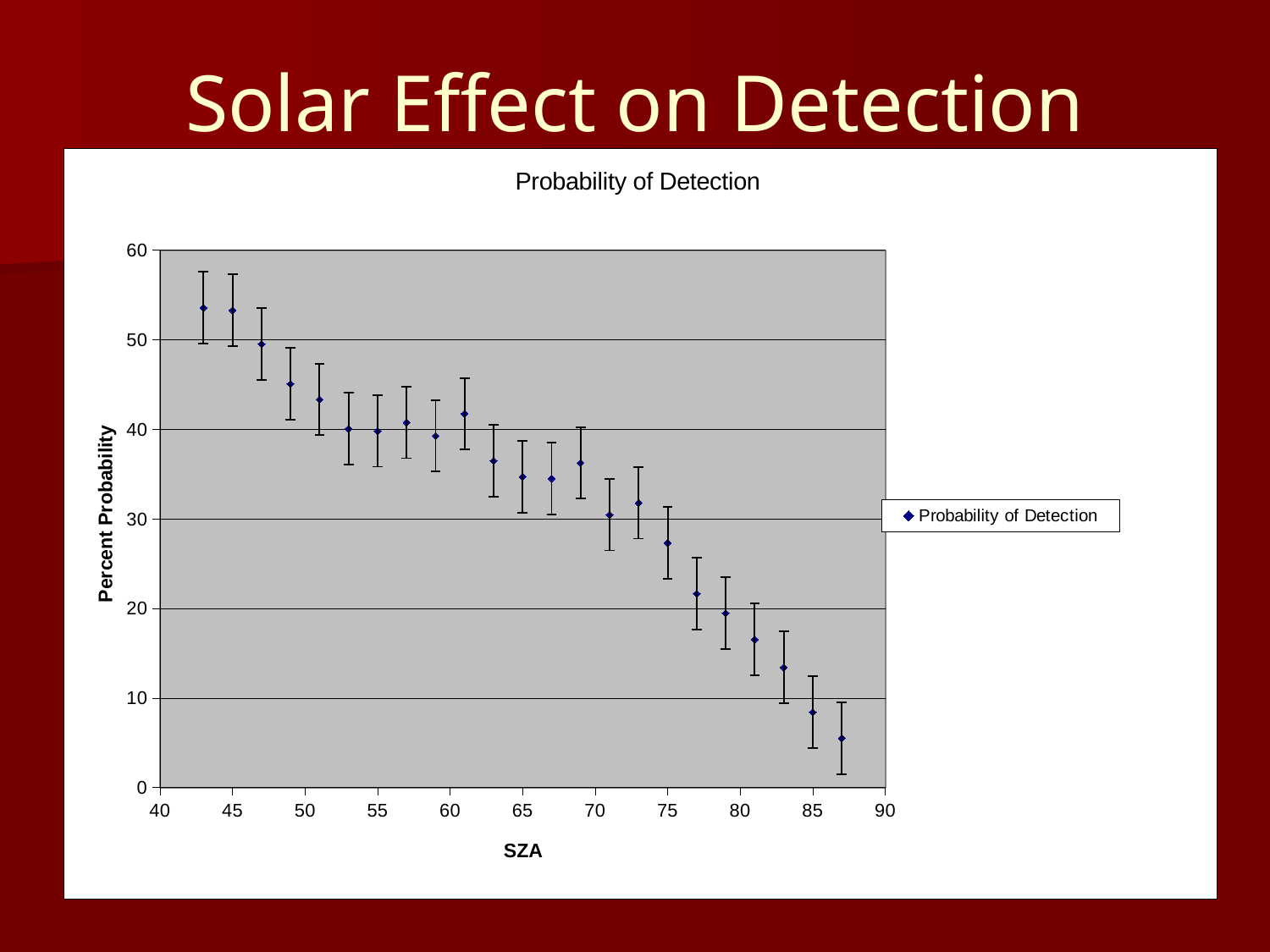
At which SZA is the plotted probability lowest? 87 What kind of chart is shown on the slide? Scatter chart Is the value at SZA 75 greater or less than 30? less What is the title of the chart? Probability of Detection Do the values rise or fall as SZA increases along the x axis? Fall Is the value at SZA 43 greater or less than 50? greater Is the value at SZA 83 greater or less than 10? greater How many data points are plotted on the chart? 23 How many series does the legend list? 1 What is the label of the y axis? Percent Probability Which has the larger probability of detection, SZA 43 or SZA 87? SZA 43